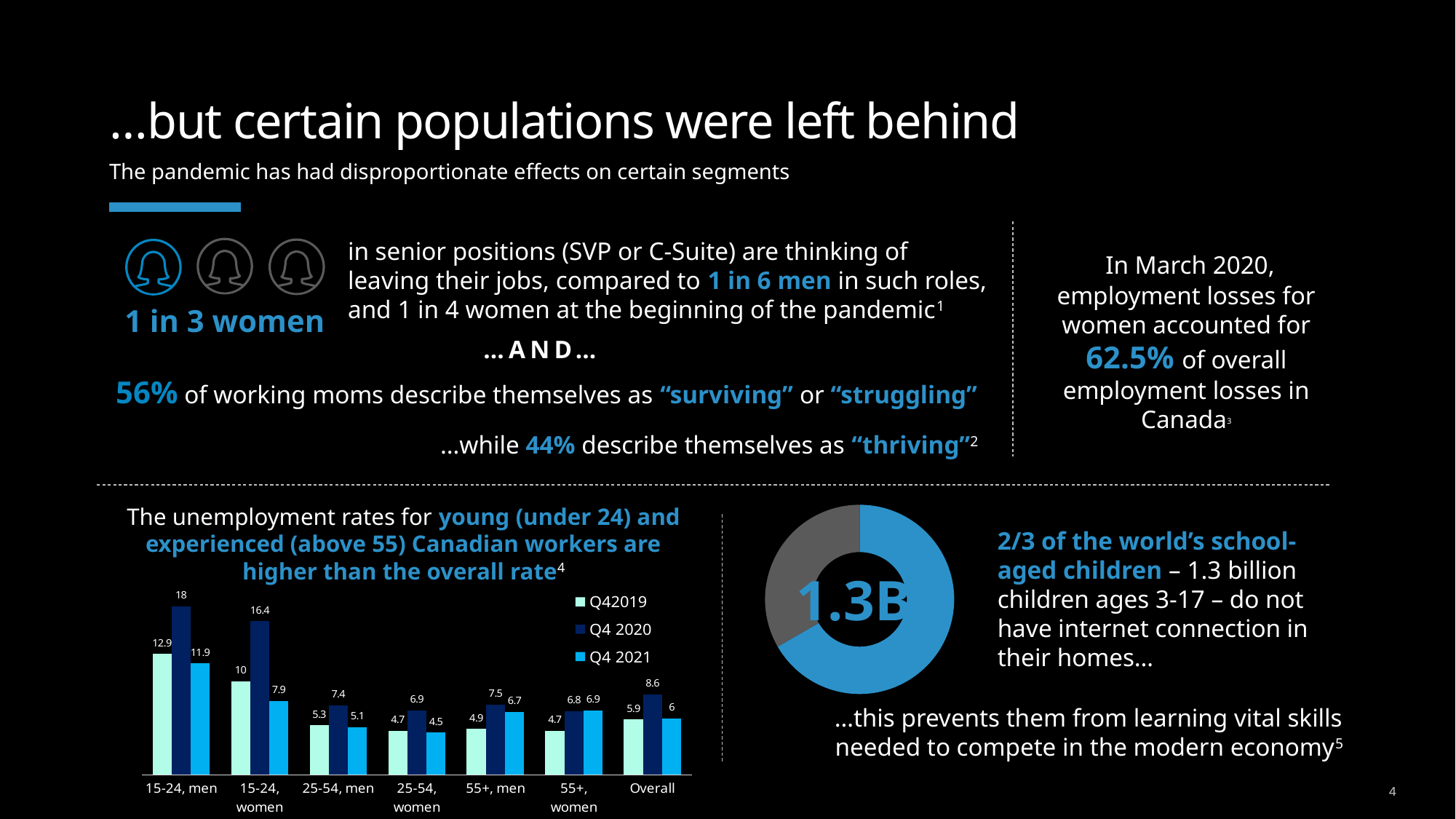
How many categories are shown on the x axis of the unemployment rates bar chart? 7 What kind of chart is the chart showing 1.3B at the bottom right of the slide? donut chart In the unemployment rates bar chart, what is the Q42019 value for Overall? 5.9 In the unemployment rates bar chart, what is the difference between the Q4 2020 and Q42019 values for 15-24, women? 6.4 In the unemployment rates bar chart, which category has the lowest Q4 2021 value? 25-54, women In the unemployment rates bar chart, which is larger for 55+, men: the Q4 2020 value or the Q4 2021 value? Q4 2020 In the unemployment rates bar chart, which category has the highest Q4 2020 value? 15-24, men How many series does the legend of the unemployment rates bar chart list? 3 What kind of chart is the unemployment rates chart at the bottom left of the slide? bar chart In the unemployment rates bar chart, what is the Q4 2020 value for Overall? 8.6 In the unemployment rates bar chart, what is the Q4 2021 value for 15-24, women? 7.9 In the unemployment rates bar chart, what is the Q4 2020 value for 15-24, men? 18